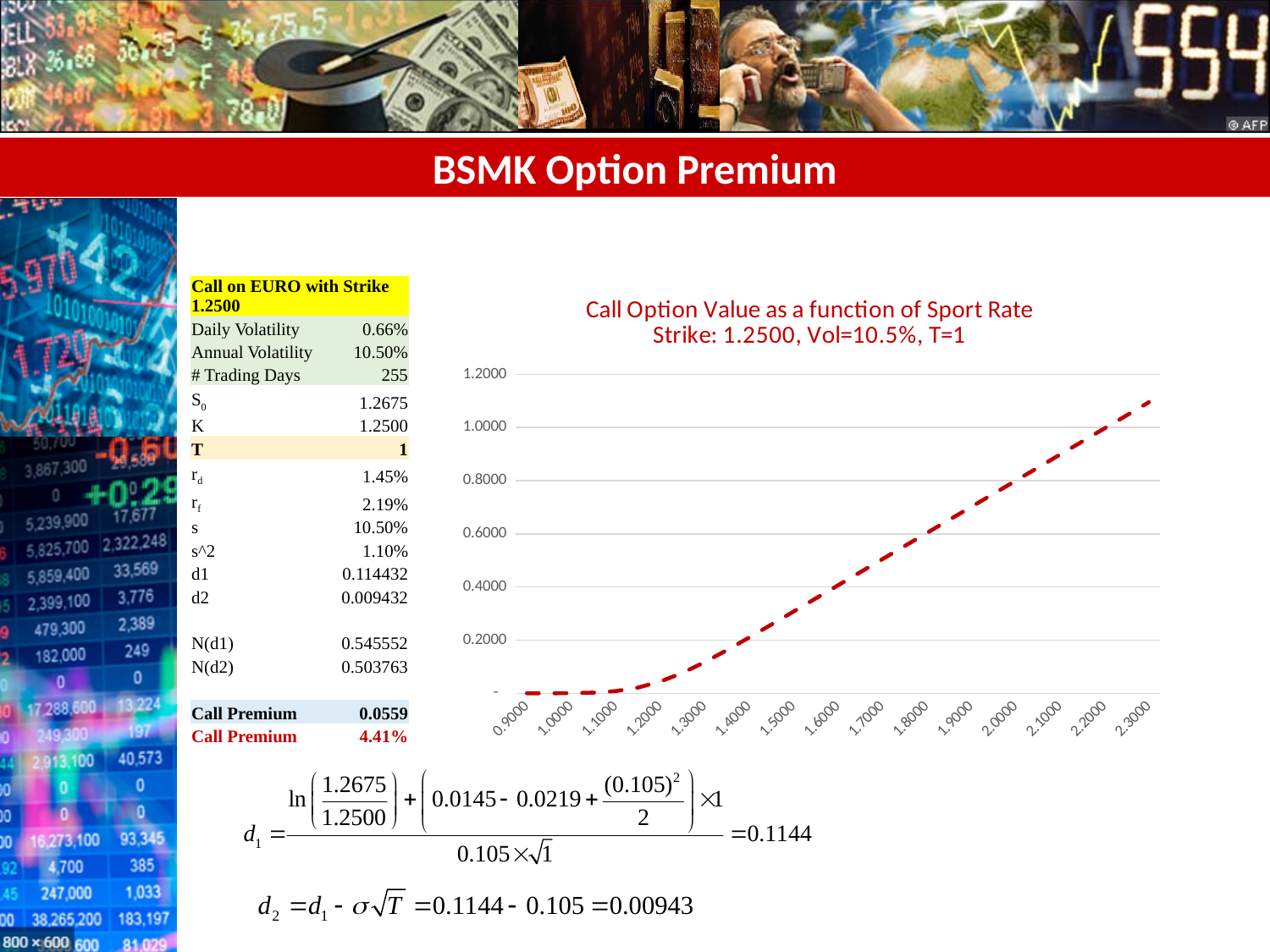
Which spot rate has the larger call option value, 1.5000 or 2.0000? 2.0000 How many spot rate values are marked along the x axis of the chart? 15 Is the call option value at a spot rate of 1.5000 greater or less than 0.4000? less Does the call option value rise or fall as the spot rate increases along the x axis? rise Is the call option value at a spot rate of 2.1000 greater or less than 0.8000? greater What is the highest value labelled on the y axis of the chart? 1.2000 At which spot rate on the x axis is the call option value highest? 2.3000 Is the call option value at a spot rate of 1.9000 greater or less than 0.6000? greater What is the title of the chart? Call Option Value as a function of Sport Rate Strike: 1.2500, Vol=10.5%, T=1 What kind of chart is shown on the slide? line chart